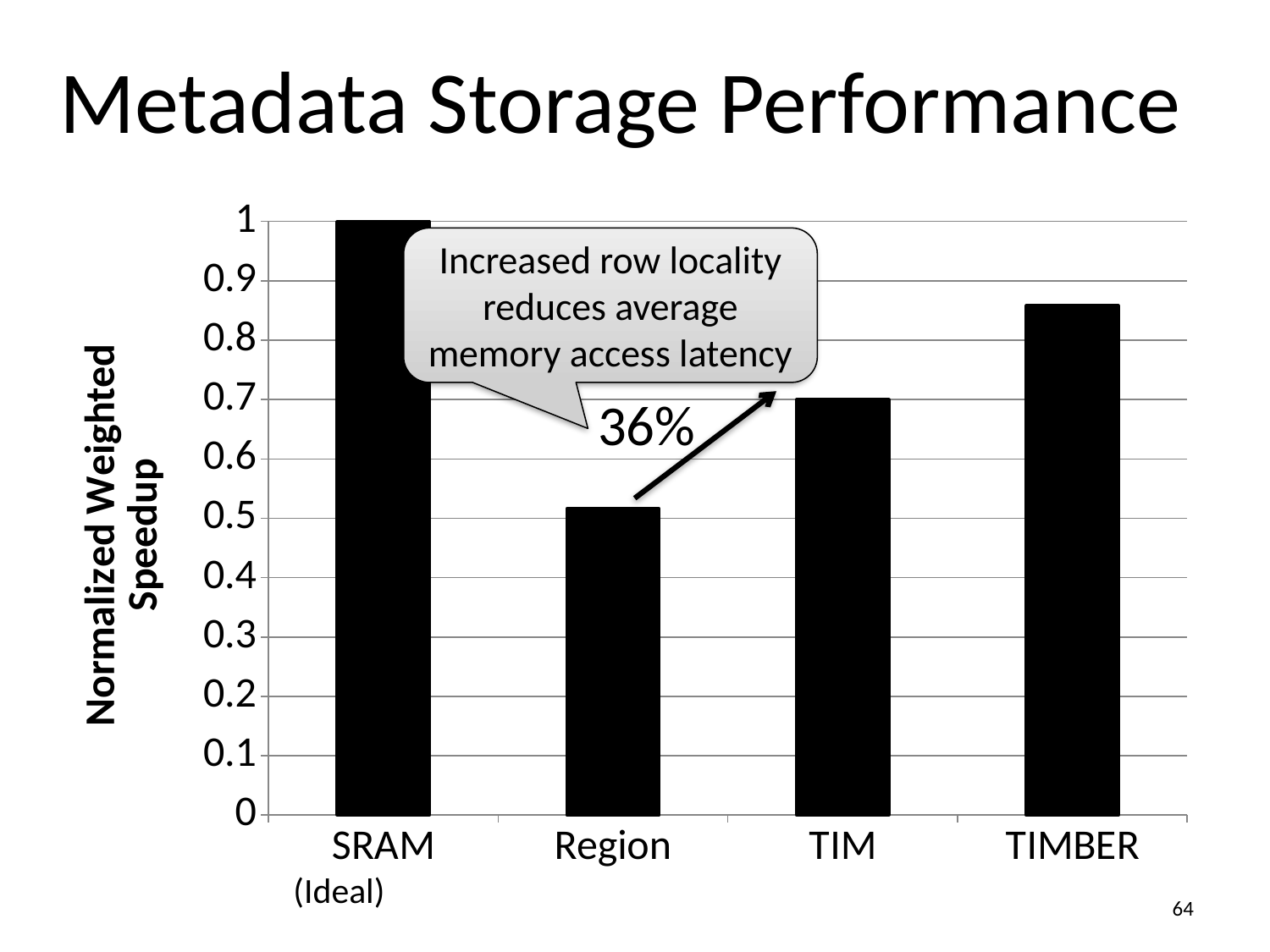
What is the normalized weighted speedup for SRAM (Ideal)? 1 Which category has the highest normalized weighted speedup? SRAM (Ideal) Which has a higher normalized weighted speedup, Region or TIM? TIM Is the value for TIM greater or less than 0.6? greater Which has a higher normalized weighted speedup, TIMBER or TIM? TIMBER Is the value for Region greater or less than 0.6? less What is the label of the y axis? Normalized Weighted Speedup What kind of chart is shown on the slide? bar chart Which category has the lowest normalized weighted speedup? Region Is the value for TIMBER greater or less than 0.8? greater How many categories are plotted on the x axis? 4 What percentage improvement is annotated between the Region and TIM bars? 36%